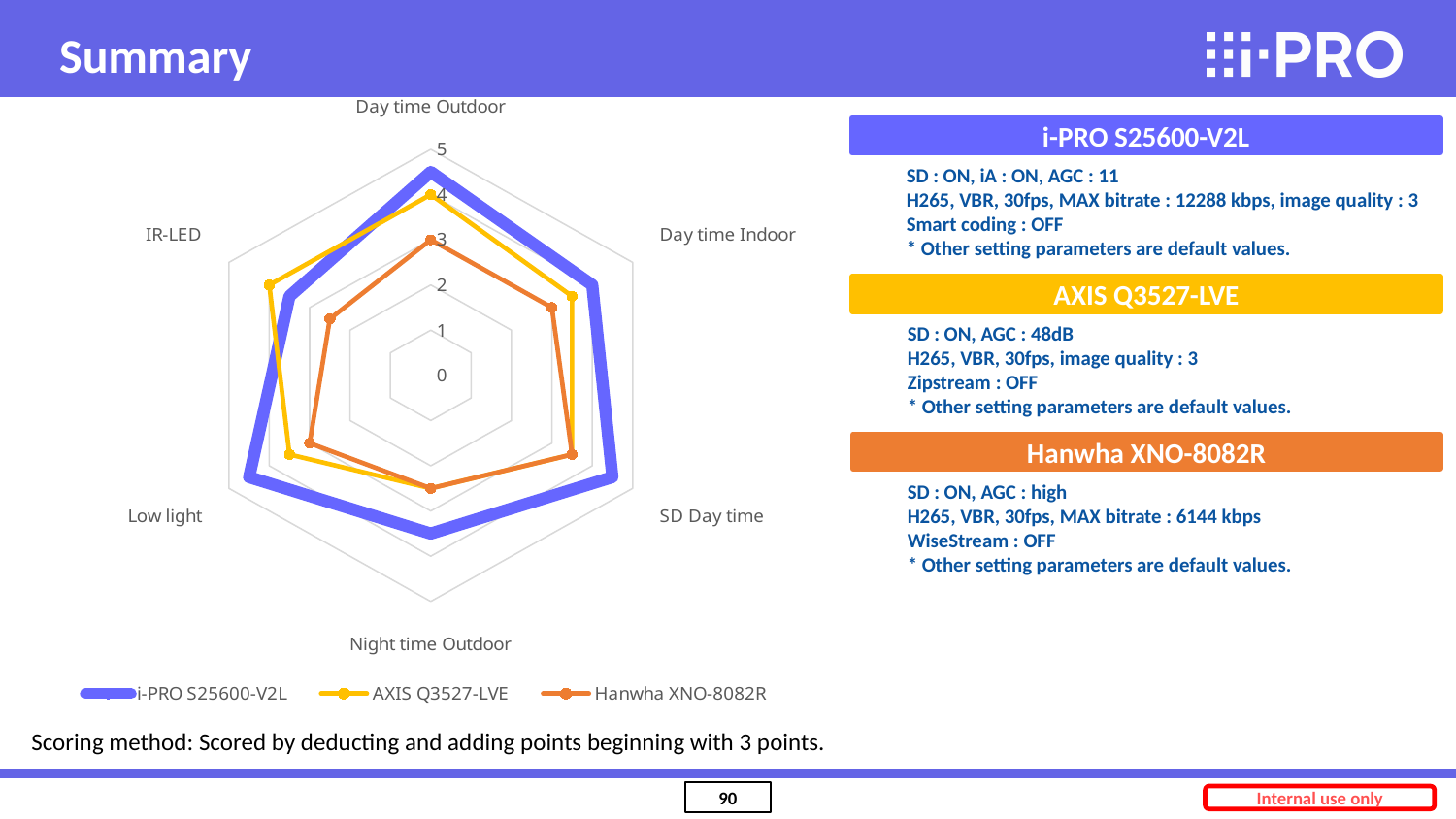
What is the maximum value shown on the chart's scale? 5 Which series scores lowest on the Day time Outdoor axis? Hanwha XNO-8082R How many categories (axes) does the radar chart have? 6 How many series does the chart legend list? 3 Is the value for i-PRO S25600-V2L on the Day time Outdoor axis greater or less than 4? greater Is the value for i-PRO S25600-V2L on the SD Day time axis greater or less than 4? greater Is the value for Hanwha XNO-8082R on the Day time Outdoor axis greater or less than 4? less Which series scores highest on the SD Day time axis? i-PRO S25600-V2L What kind of chart is shown on the slide? Radar chart Which series scores highest on the Day time Outdoor axis? i-PRO S25600-V2L On the IR-LED axis, which scores higher: AXIS Q3527-LVE or i-PRO S25600-V2L? AXIS Q3527-LVE Which series is drawn in yellow on the chart? AXIS Q3527-LVE